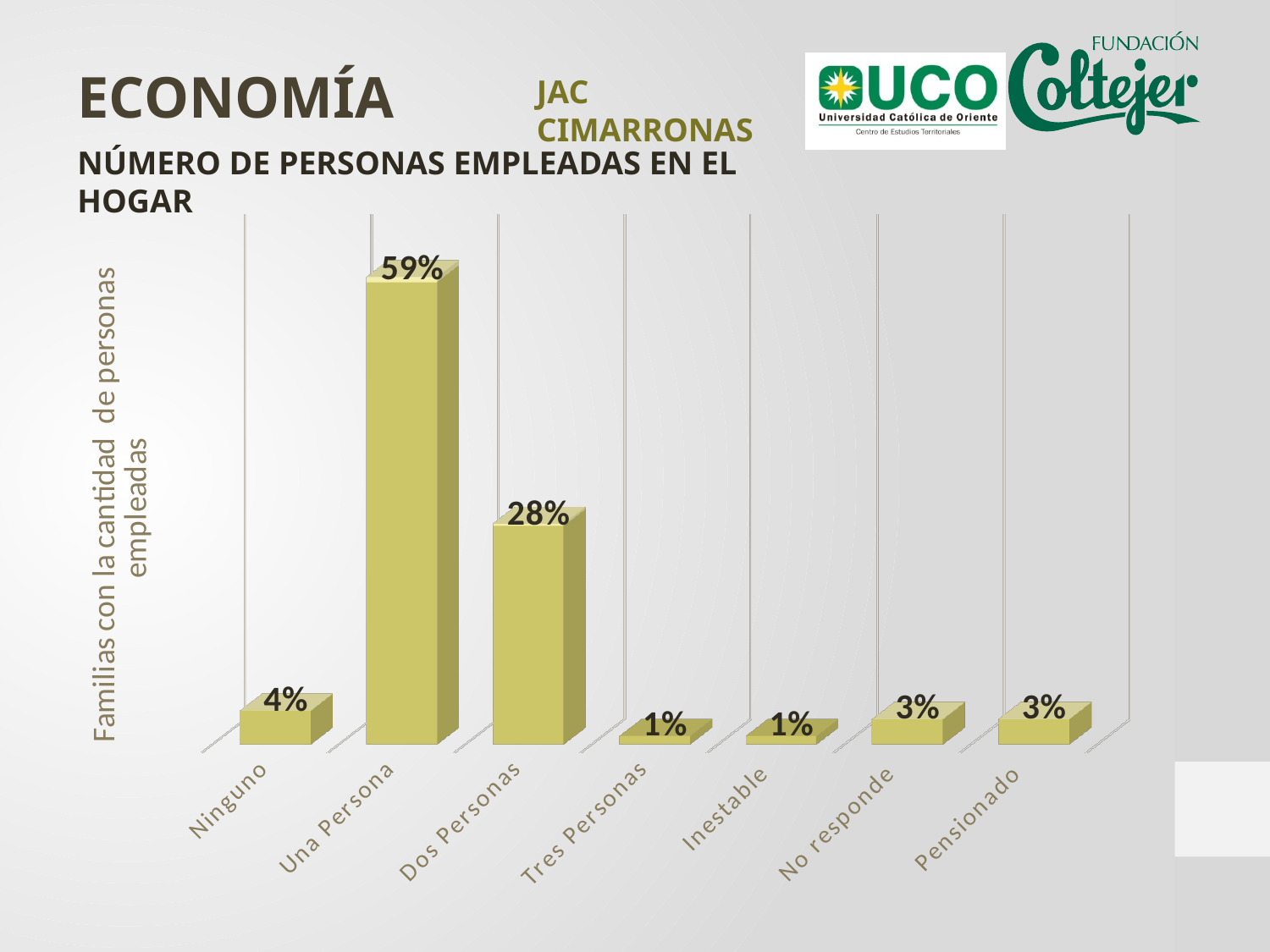
What is the value for Ninguno? 4% What is the difference between the values for Ninguno and No responde? 1% Which is larger, the value for Ninguno or the value for Inestable? Ninguno Which category has the highest value? Una Persona What is the value for Dos Personas? 28% What is the label on the vertical axis of the chart? Familias con la cantidad de personas empleadas What is the value for Pensionado? 3% What is the title of the chart? NÚMERO DE PERSONAS EMPLEADAS EN EL HOGAR What is the difference between the values for Una Persona and Dos Personas? 31% What kind of chart is shown on the slide? Bar chart What is the value for Una Persona? 59% How many categories are shown on the x axis? 7